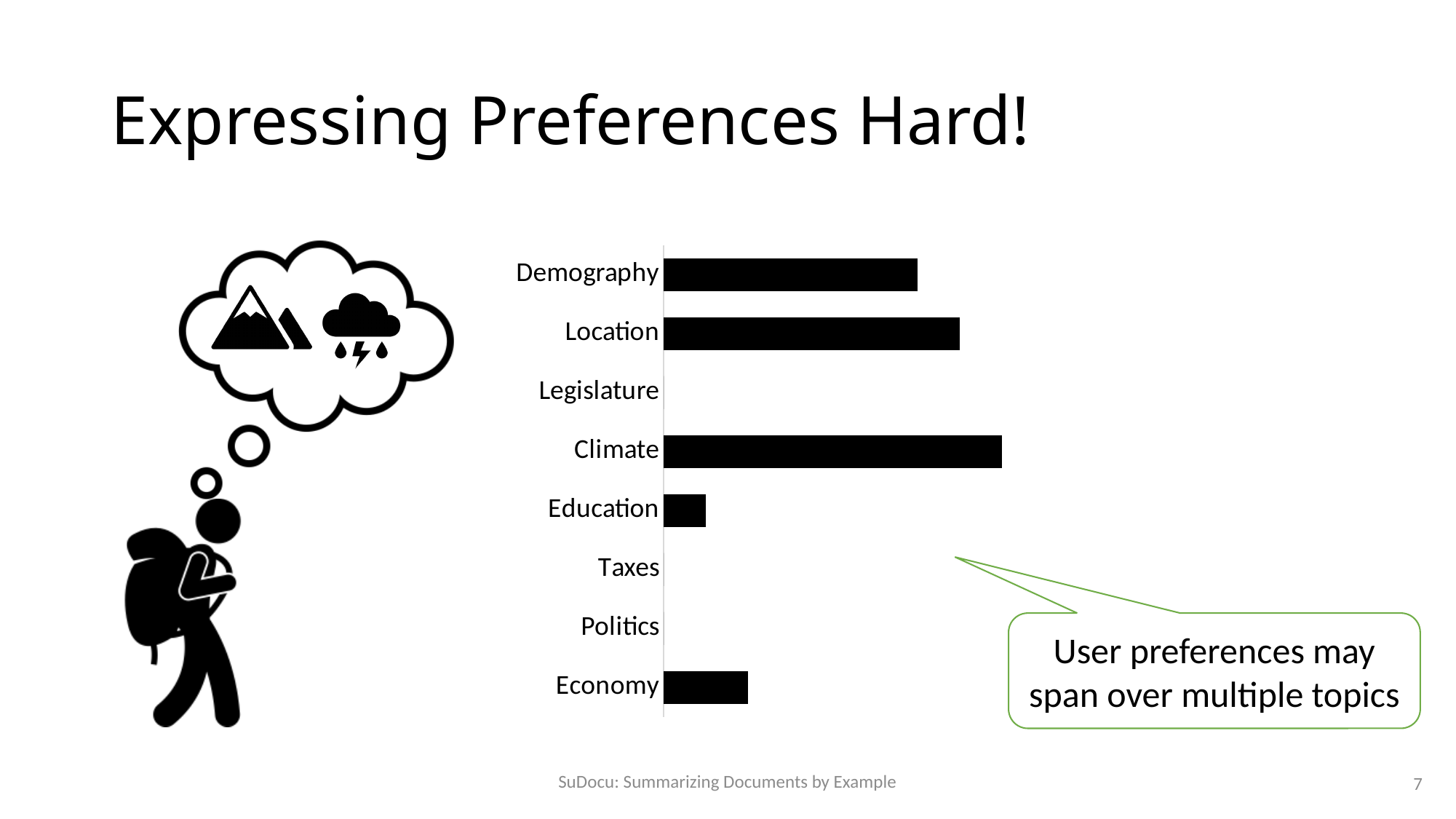
Which bar is longer, Location or Demography? Location Which category has the longest bar in the chart? Climate Which categories on the chart show no visible bar? Legislature, Taxes, Politics What is the category label of the topmost bar in the chart? Demography Among the categories that have a visible bar, which has the shortest bar? Education Which category has the second-longest bar in the chart? Location Which bar is longer, Economy or Climate? Climate Which bar is longer, Climate or Demography? Climate What is the category label of the bottommost bar in the chart? Economy How many categories are listed on the chart's vertical axis? 8 What kind of chart is shown on the slide? Bar chart